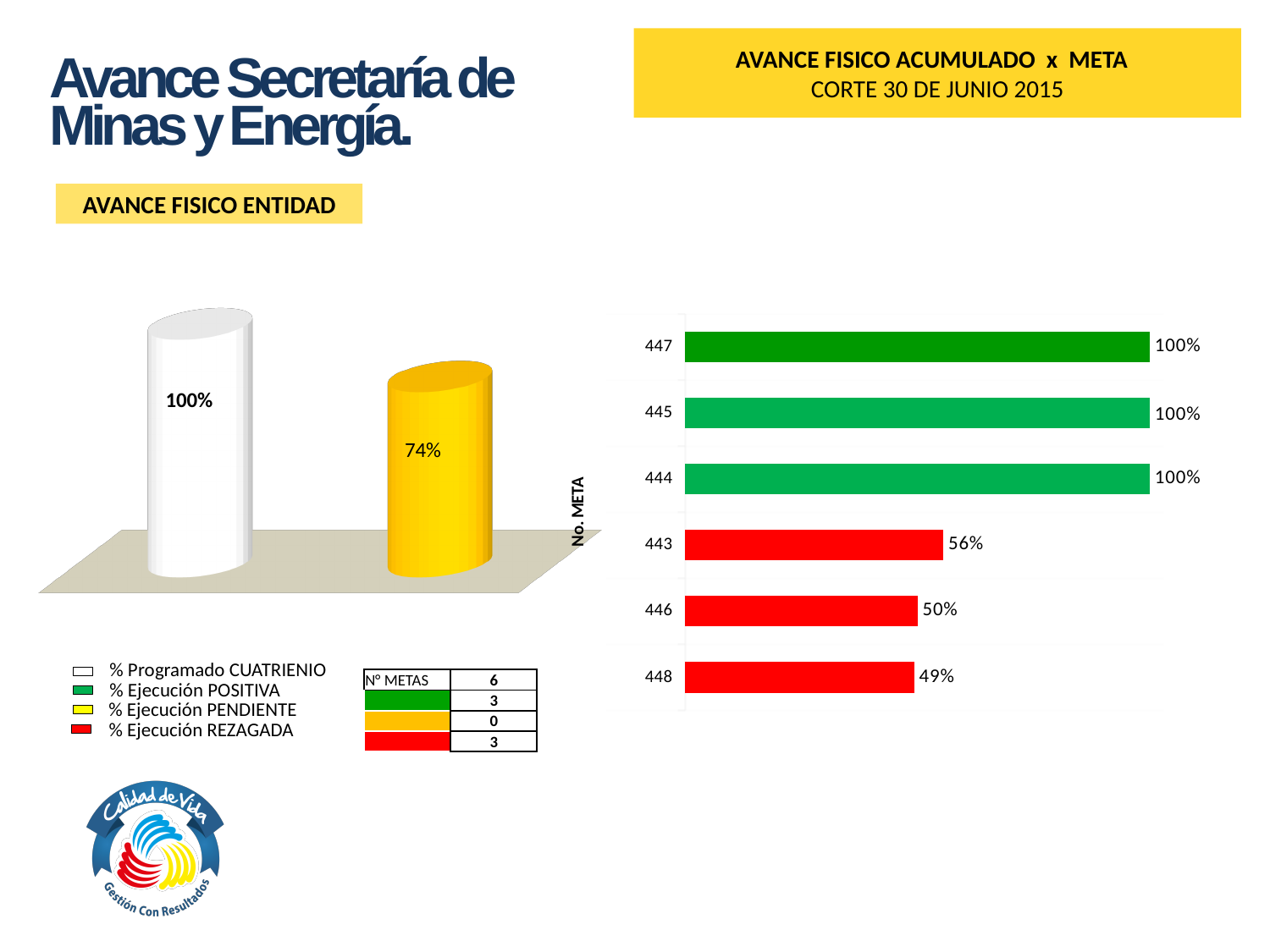
In the AVANCE FISICO ACUMULADO x META chart, what is the value for meta 448? 49% In the AVANCE FISICO ACUMULADO x META chart, which is larger, the value for meta 443 or the value for meta 446? 443 In the AVANCE FISICO ENTIDAD chart, what is the value of the yellow bar? 74% In the AVANCE FISICO ACUMULADO x META chart, what is the value for meta 443? 56% In the AVANCE FISICO ENTIDAD chart, what is the difference between the white bar and the yellow bar? 26% In the AVANCE FISICO ACUMULADO x META chart, what is the label of the vertical axis? No. META What kind of chart is the AVANCE FISICO ACUMULADO x META chart? bar chart In the AVANCE FISICO ACUMULADO x META chart, what is the difference between the values for meta 447 and meta 443? 44% In the AVANCE FISICO ACUMULADO x META chart, how many metas have a value of 100%? 3 In the AVANCE FISICO ACUMULADO x META chart, what is the value for meta 446? 50% In the AVANCE FISICO ACUMULADO x META chart, which meta has the lowest value? 448 In the AVANCE FISICO ACUMULADO x META chart, how many metas are plotted? 6